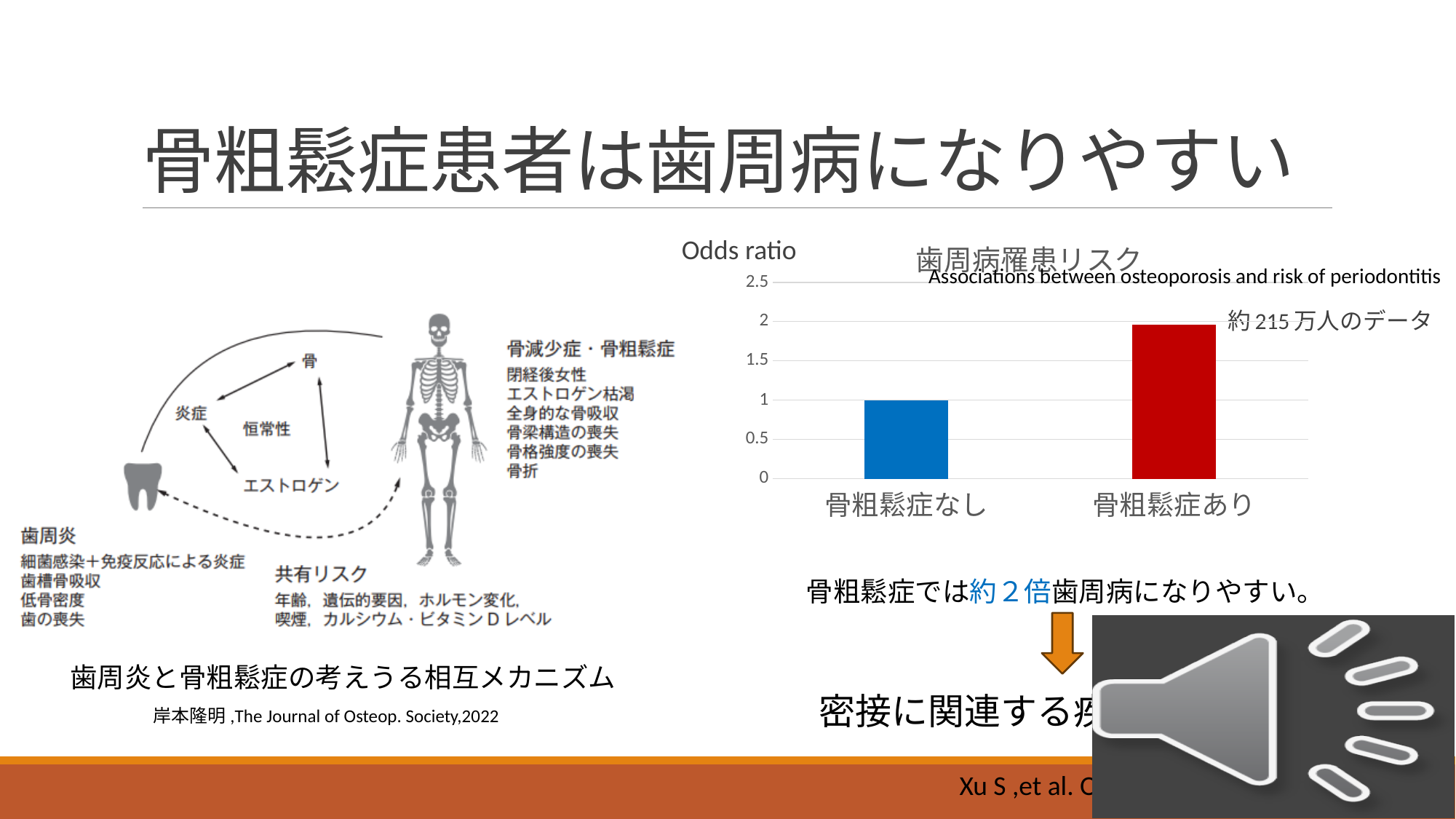
Which category has the lowest odds ratio? 骨粗鬆症なし What is the highest value shown on the vertical axis of the chart? 2.5 What kind of chart is shown on the slide? bar chart Which is larger, the odds ratio for 骨粗鬆症あり or for 骨粗鬆症なし? 骨粗鬆症あり What is the title of the chart? 歯周病罹患リスク Which category has the highest odds ratio? 骨粗鬆症あり Is the odds ratio for 骨粗鬆症あり greater or less than 1.5? greater What is the odds ratio for 骨粗鬆症なし? 1 How many categories are plotted in the chart? 2 What label is shown on the vertical axis of the chart? Odds ratio